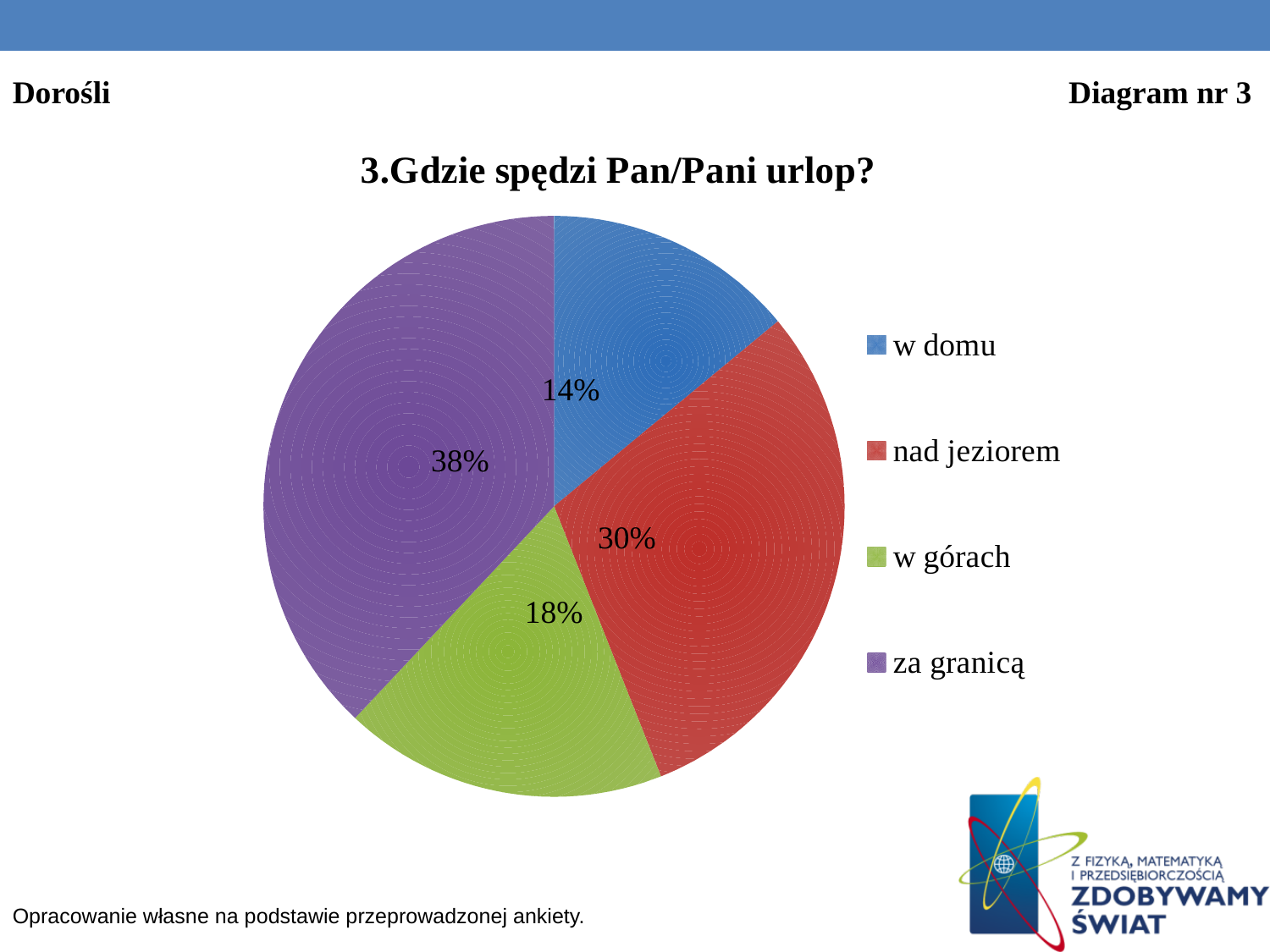
What is the difference in percentage points between "w górach" and "w domu"? 4 Which is larger, the share for "nad jeziorem" or the share for "w górach"? nad jeziorem What is the title of the chart? 3.Gdzie spędzi Pan/Pani urlop? Which category has the largest slice of the pie? za granicą What share of the pie does "w domu" have? 14% How many categories does the pie chart show? 4 What is the difference in percentage points between "za granicą" and "nad jeziorem"? 8 What share of the pie does "za granicą" have? 38% What kind of chart is shown on the slide? pie chart Which category has the smallest slice of the pie? w domu What share of the pie does "nad jeziorem" have? 30%